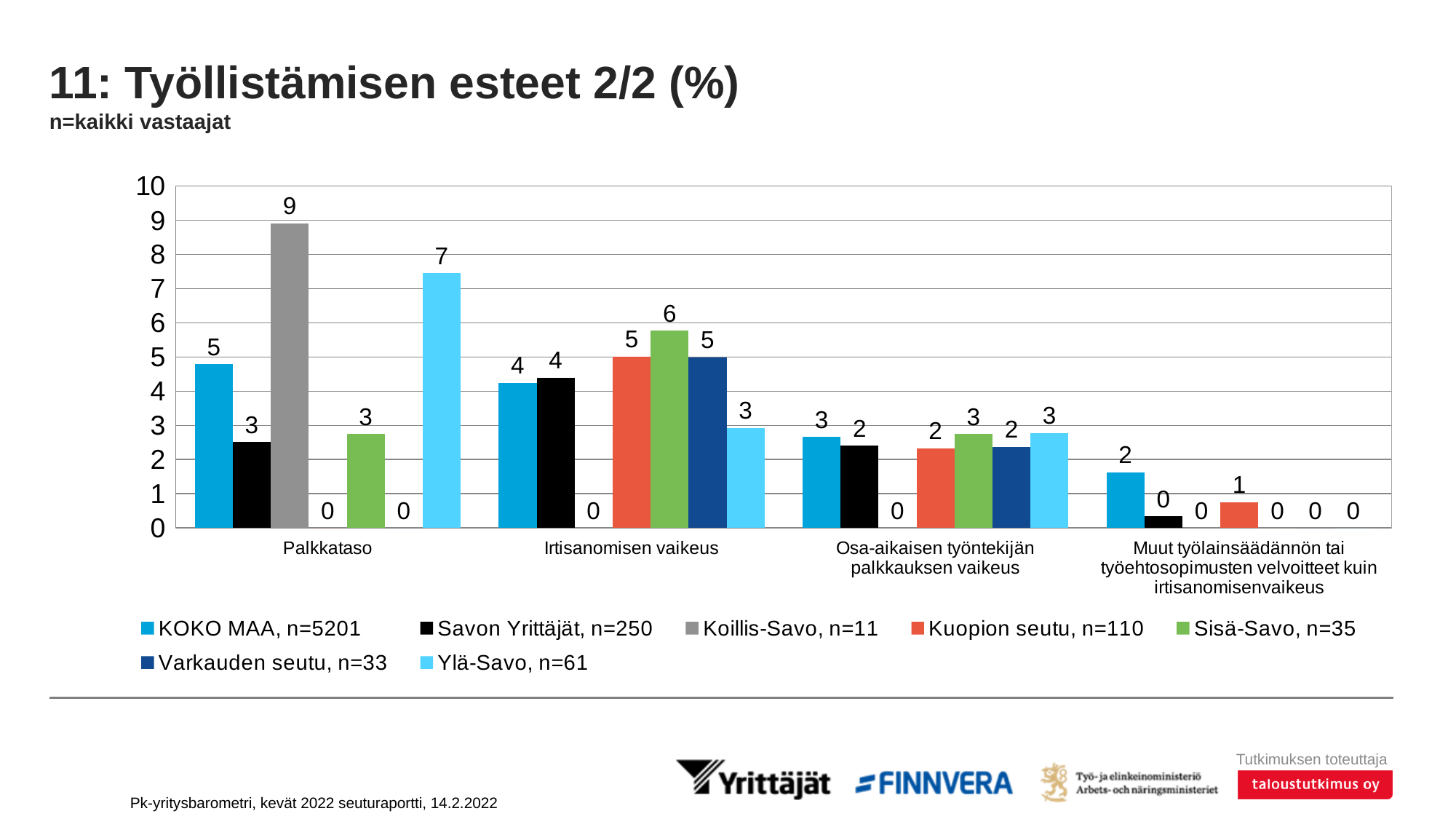
For Ylä-Savo, n=61, which category has the larger value: Palkkataso or Irtisanomisen vaikeus? Palkkataso What is the value for Koillis-Savo, n=11 in the Palkkataso category? 9 What is the value for Sisä-Savo, n=35 in the Irtisanomisen vaikeus category? 6 Which series has the highest value in the Irtisanomisen vaikeus category? Sisä-Savo, n=35 What kind of chart is shown on the slide? Bar chart What is the title of the chart on the slide? 11: Työllistämisen esteet 2/2 (%) How many series does the legend list? 7 How many categories are shown on the x axis? 4 What is the value for Ylä-Savo, n=61 in the Palkkataso category? 7 What is the value for Kuopion seutu, n=110 in the category 'Muut työlainsäädännön tai työehtosopimusten velvoitteet kuin irtisanomisenvaikeus'? 1 In the Palkkataso category, what is the difference between the values for Koillis-Savo, n=11 and KOKO MAA, n=5201? 4 Which series has the highest value in the Palkkataso category? Koillis-Savo, n=11